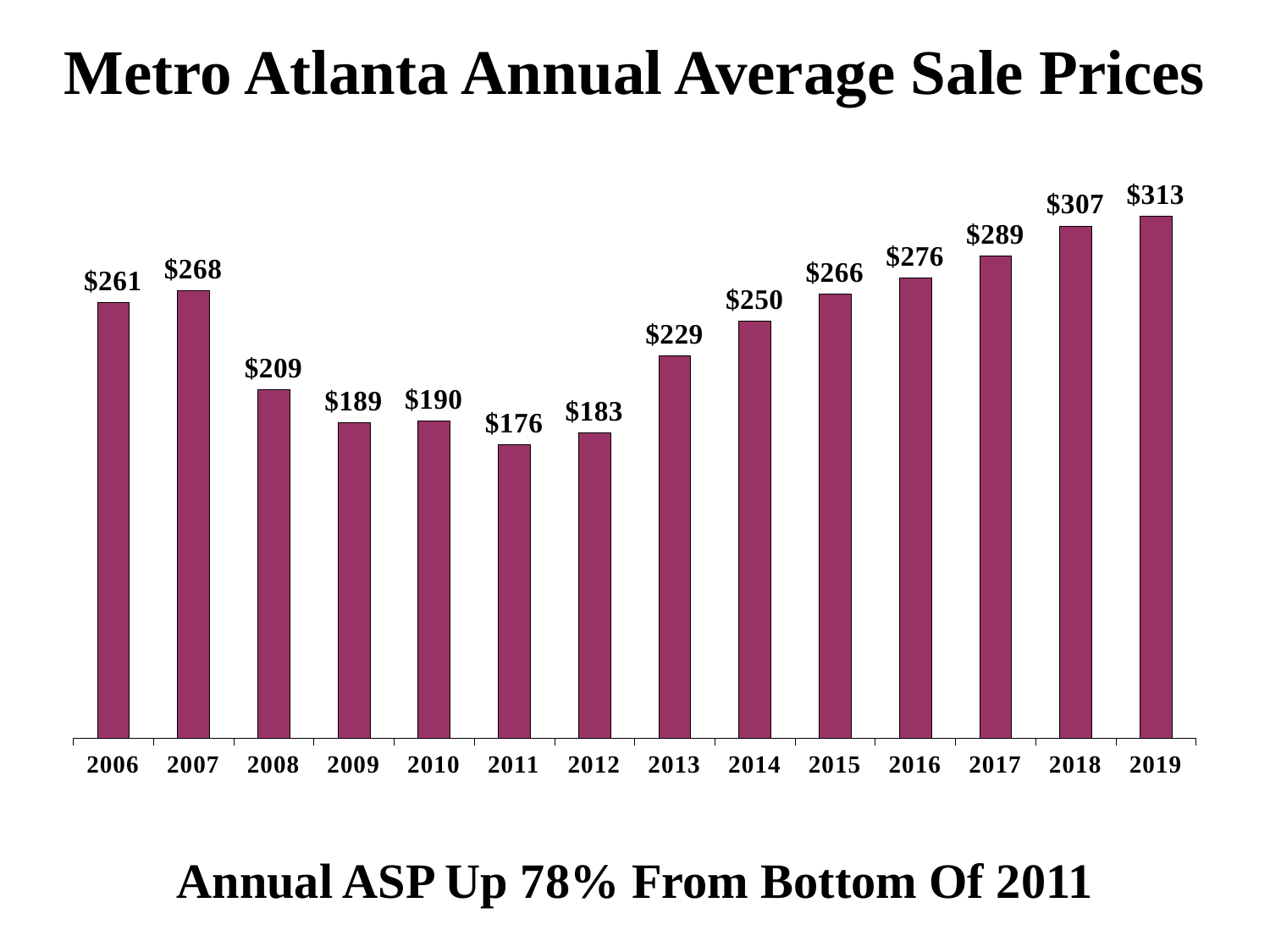
Which year has the lowest average sale price? 2011 How many years are shown on the x axis? 14 What is the difference between the 2019 value and the 2011 value? $137 Do the values rise or fall from 2011 to 2019? rise What is the difference between the 2007 value and the 2008 value? $59 Which year has the highest average sale price? 2019 What kind of chart is this? bar chart Which is larger, the value for 2006 or the value for 2015? 2015 What is the average sale price shown for 2014? $250 What is the title of the chart? Metro Atlanta Annual Average Sale Prices What is the average sale price shown for 2019? $313 What is the average sale price shown for 2011? $176